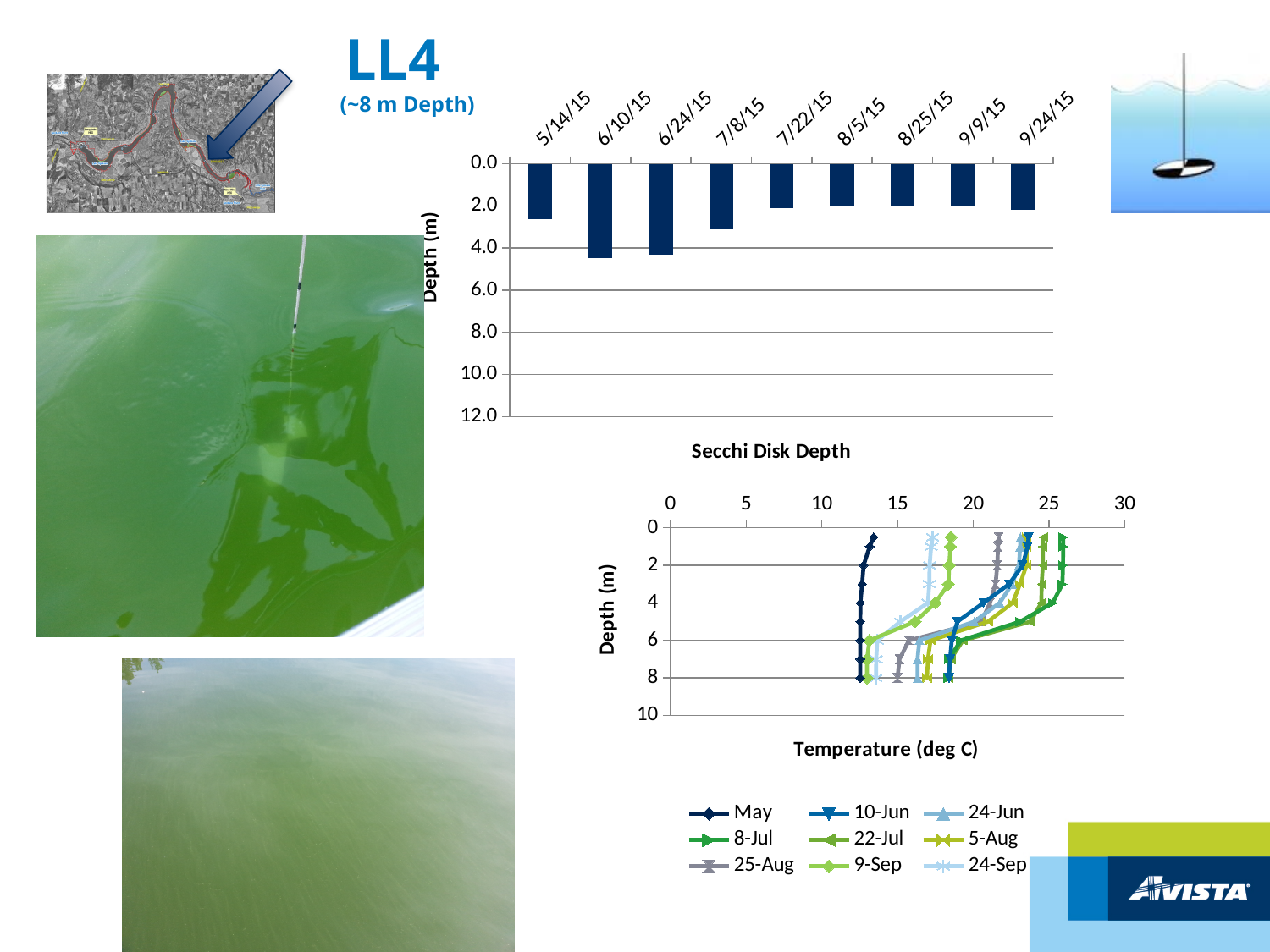
How many sampling dates are shown on the Secchi Disk Depth chart? 9 On the Secchi Disk Depth chart, is the depth for 6/10/15 greater or less than 4.0 m? greater On the Secchi Disk Depth chart, is the depth for 5/14/15 greater or less than 2.0 m? greater What kind of chart is the Temperature (deg C) chart? line chart On the Temperature (deg C) chart, which series has the lowest surface temperature? May On the Secchi Disk Depth chart, which date has the deeper Secchi depth, 5/14/15 or 7/8/15? 7/8/15 On the Secchi Disk Depth chart, is the depth for 7/8/15 greater or less than 4.0 m? less What kind of chart is the Secchi Disk Depth chart? bar chart What is the maximum value shown on the vertical axis of the Secchi Disk Depth chart? 12.0 On the Secchi Disk Depth chart, which date has the deeper Secchi depth, 6/10/15 or 7/22/15? 6/10/15 How many series does the legend of the Temperature (deg C) chart list? 9